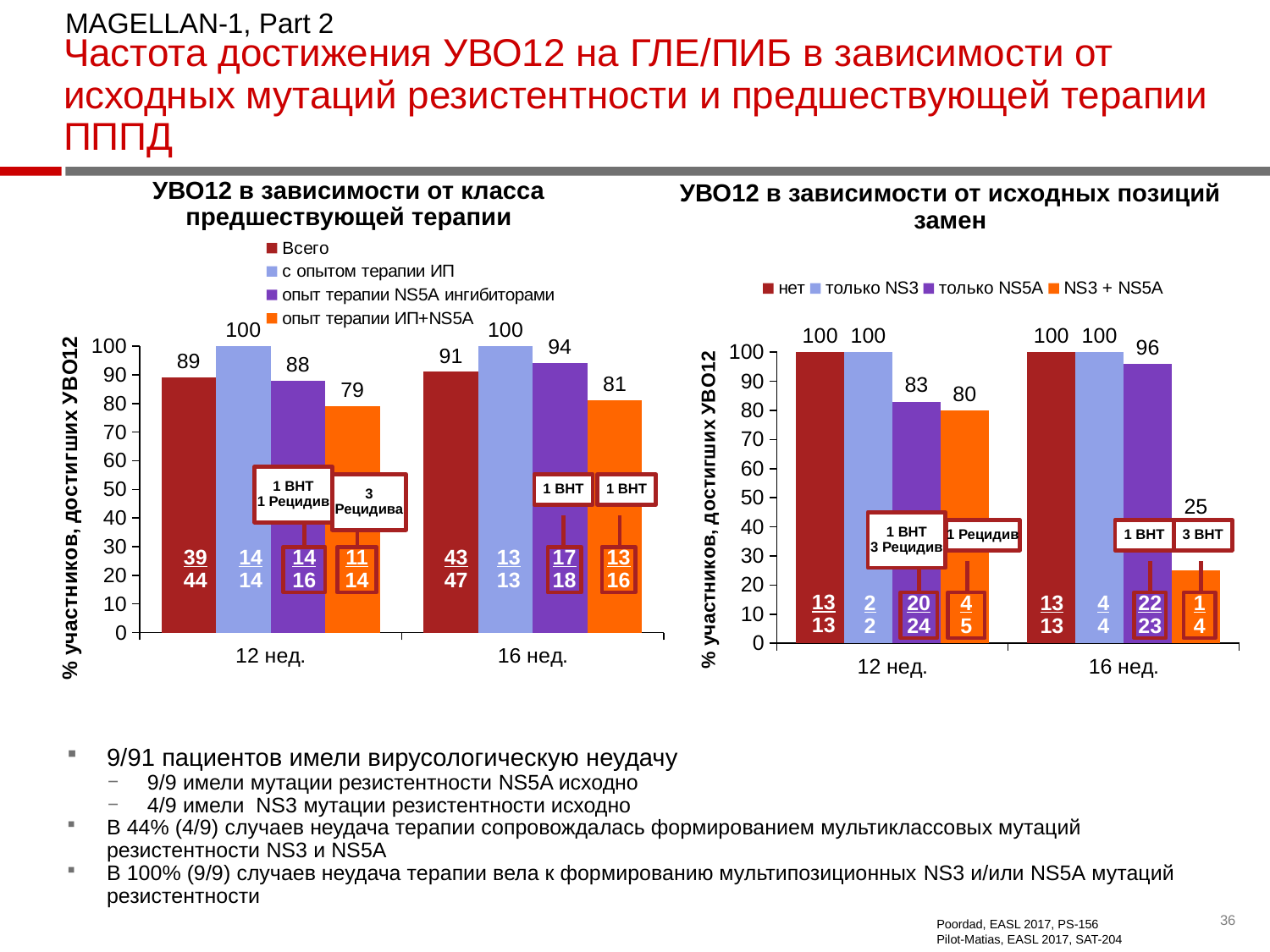
In the right chart (УВО12 в зависимости от исходных позиций замен), is the value for 'только NS5A' at 16 нед. larger or smaller than at 12 нед.? larger In the left chart (УВО12 в зависимости от класса предшествующей терапии), which series has the lowest value at 16 нед.? опыт терапии ИП+NS5A In the right chart (УВО12 в зависимости от исходных позиций замен), which series has the lowest value at 16 нед.? NS3 + NS5A In the left chart (УВО12 в зависимости от класса предшествующей терапии), what is the value for 'опыт терапии ИП+NS5A' at 12 нед.? 79 In the left chart (УВО12 в зависимости от класса предшествующей терапии), how many series does the legend list? 4 In the right chart (УВО12 в зависимости от исходных позиций замен), what is the value for 'NS3 + NS5A' at 16 нед.? 25 How many x-axis categories does the left chart (УВО12 в зависимости от класса предшествующей терапии) have? 2 What kind of chart is the right chart (УВО12 в зависимости от исходных позиций замен)? bar chart In the right chart (УВО12 в зависимости от исходных позиций замен), what is the difference between the 'NS3 + NS5A' values at 12 нед. and 16 нед.? 55 In the right chart (УВО12 в зависимости от исходных позиций замен), what is the value for 'только NS5A' at 12 нед.? 83 In the left chart (УВО12 в зависимости от класса предшествующей терапии), what is the difference between the 'опыт терапии NS5A ингибиторами' values at 16 нед. and 12 нед.? 6 In the left chart (УВО12 в зависимости от класса предшествующей терапии), what is the value for 'Всего' at 16 нед.? 91